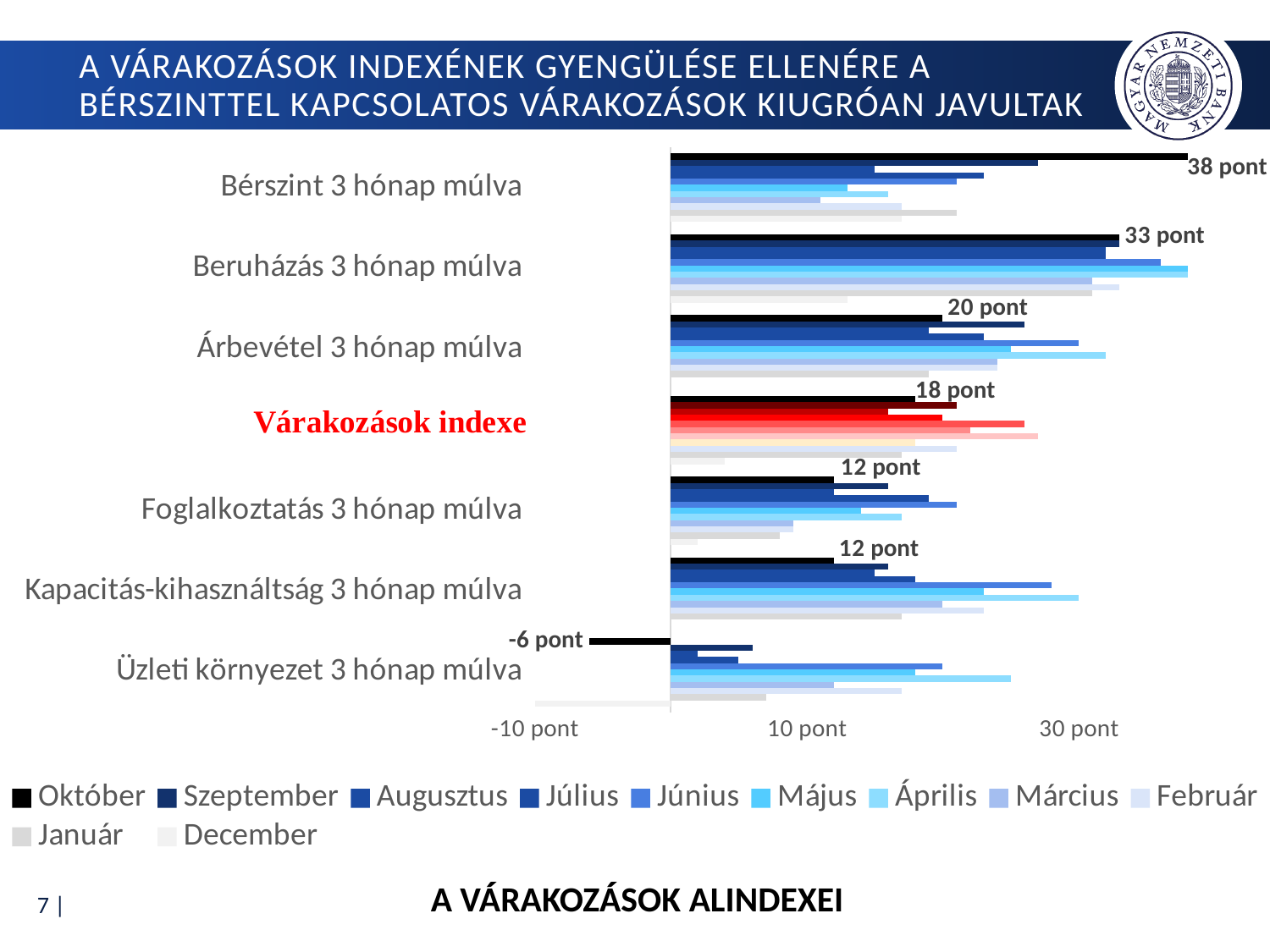
Which is larger for Október: Árbevétel 3 hónap múlva or Foglalkoztatás 3 hónap múlva? Árbevétel 3 hónap múlva What is the Október value for Üzleti környezet 3 hónap múlva? -6 pont What is the Október value for Beruházás 3 hónap múlva? 33 pont What is the Október value for Várakozások indexe? 18 pont How many series does the legend list? 11 Which category has the highest Október value? Bérszint 3 hónap múlva Which category has the lowest Október value? Üzleti környezet 3 hónap múlva What is the Október value for Bérszint 3 hónap múlva? 38 pont How many categories are shown on the chart? 7 Is the Május value for Beruházás 3 hónap múlva greater or less than 30 pont? greater What kind of chart is shown on the slide? bar chart What is the difference between the Október values for Bérszint 3 hónap múlva and Beruházás 3 hónap múlva? 5 pont